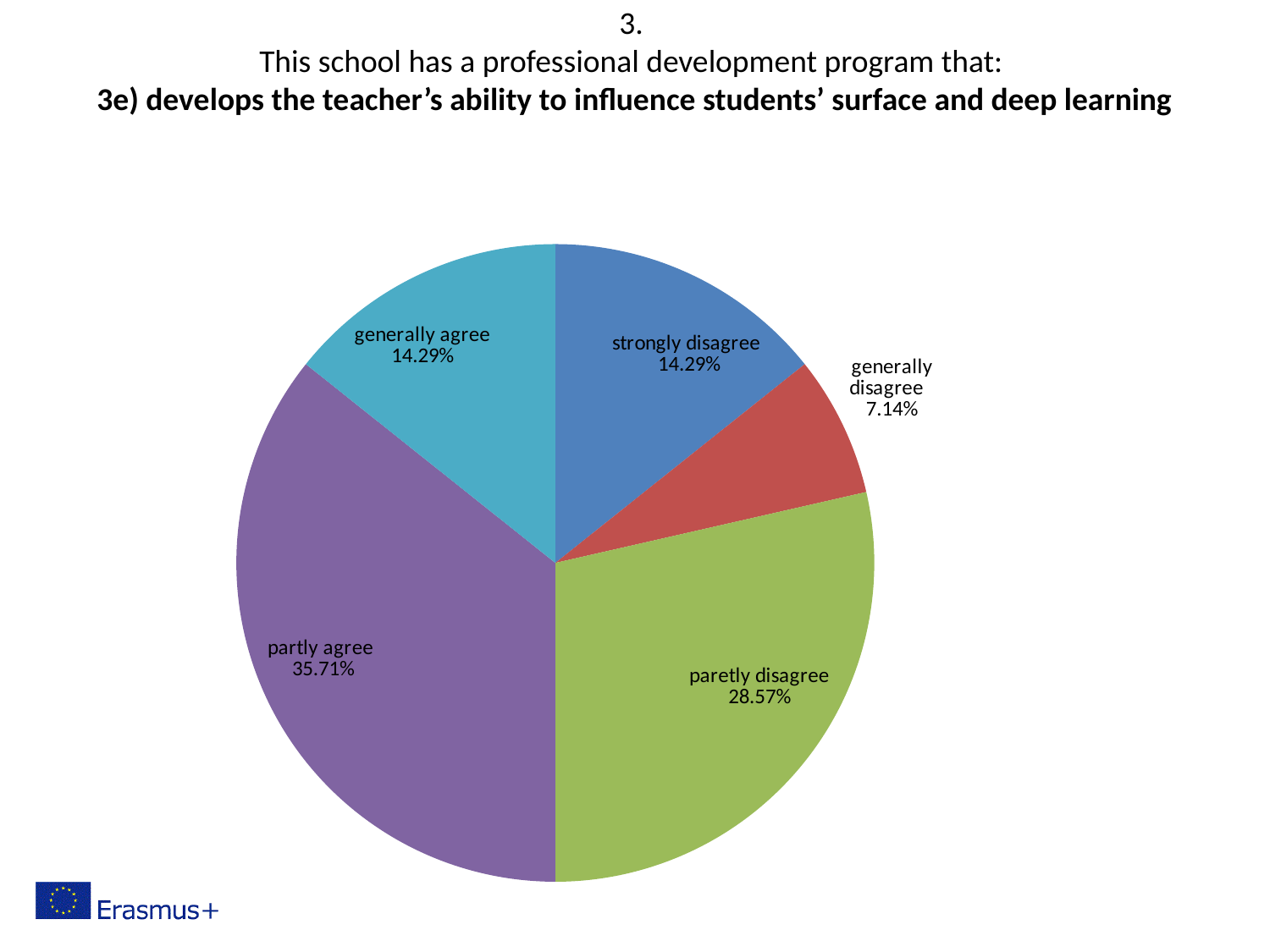
What share of the pie is labelled "generally disagree"? 7.14% Which is larger, the "strongly disagree" slice or the "generally disagree" slice? strongly disagree Which slice of the pie is the smallest? generally disagree What is the difference between the "partly agree" and "paretly disagree" shares? 7.14% What share of the pie is labelled "strongly disagree"? 14.29% Which slice of the pie is the largest? partly agree What share of the pie is labelled "partly agree"? 35.71% What colour is the "partly agree" slice? purple How many slices does the pie chart have? 5 What kind of chart is shown on the slide? pie chart